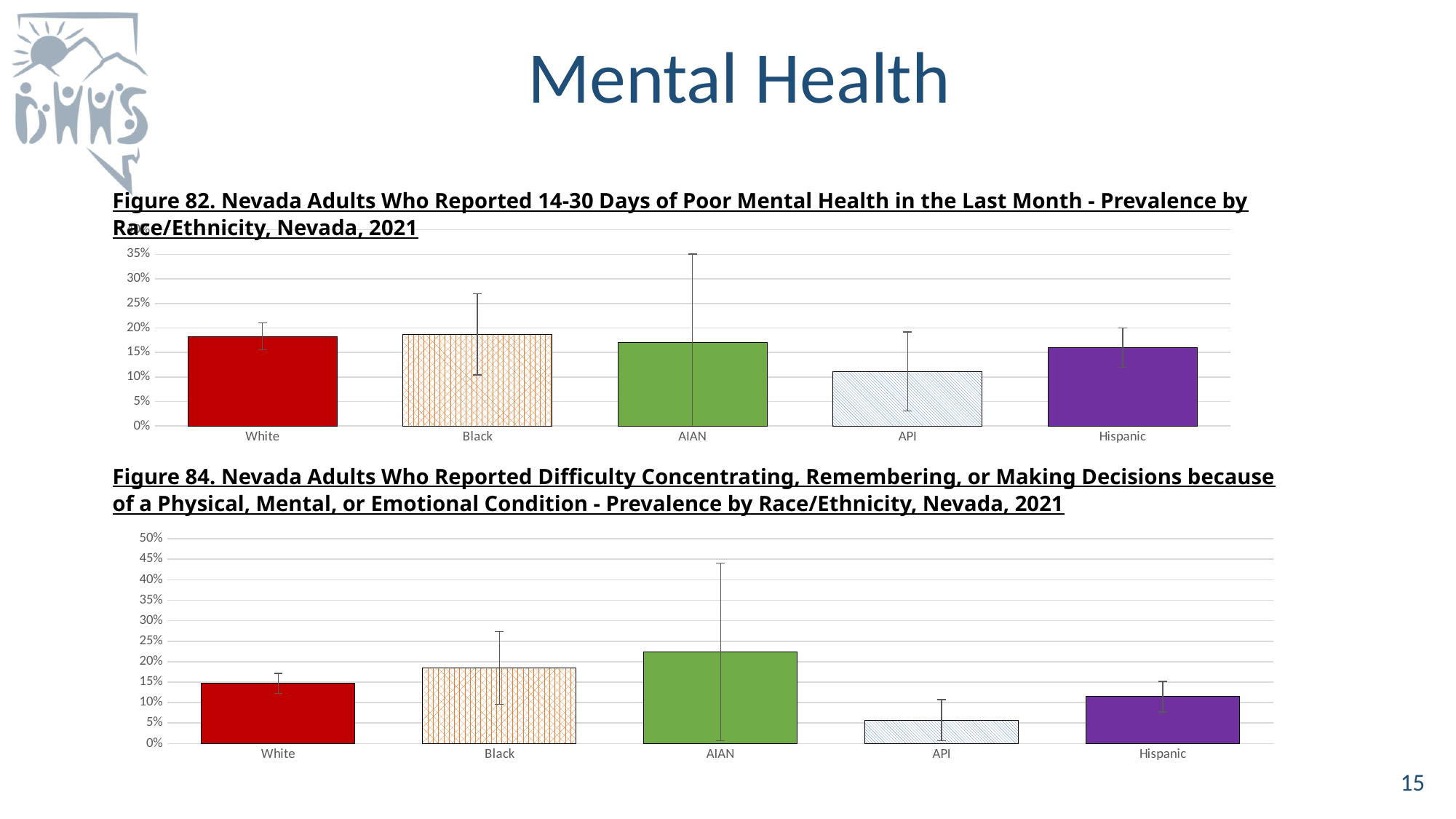
In Figure 84, is the value for AIAN greater or less than 20%? greater In Figure 82, which race/ethnicity group has the lowest prevalence? API In Figure 82, how many race/ethnicity categories are shown? 5 In Figure 82, is the value for API greater or less than 15%? less In Figure 82, what kind of chart is used? bar chart In Figure 84, is the value for API greater or less than 10%? less In Figure 82, which is larger, the value for Black or the value for API? Black In Figure 84, which race/ethnicity group has the lowest prevalence? API What year of data is shown in the title of Figure 84? 2021 In Figure 84, which is larger, the value for Black or the value for Hispanic? Black In Figure 84, which race/ethnicity group has the highest prevalence? AIAN